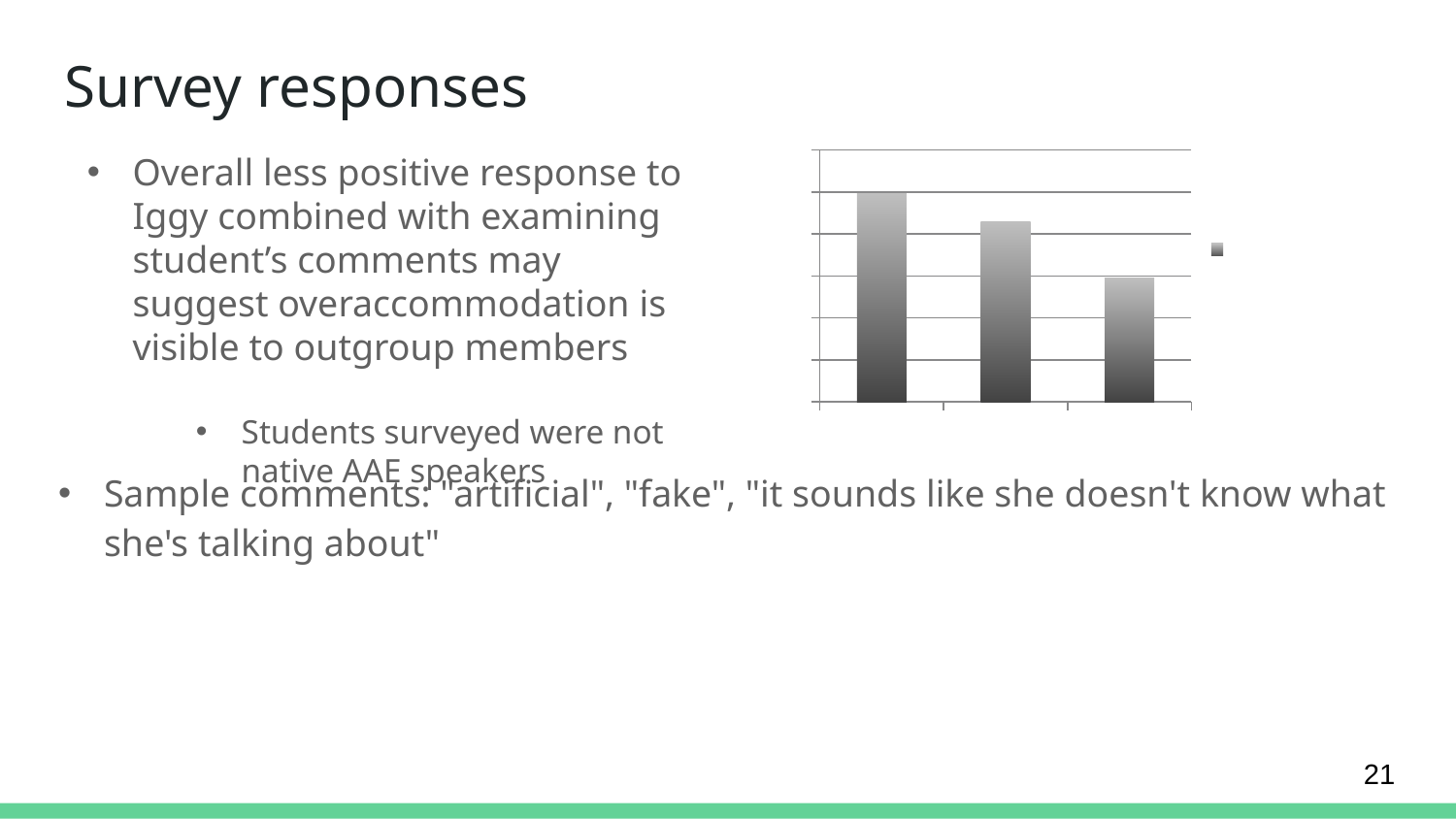
Do the bar values rise or fall from left to right across the chart? fall Which bar is the shortest in the chart: the left, middle, or right one? right How many series does the chart's legend list? 1 Is the left bar taller or shorter than the middle bar? taller Which bar is the tallest in the chart: the left, middle, or right one? left What kind of chart is shown on the slide? bar chart Are the bars in the chart vertical or horizontal? vertical How many bars are plotted in the chart? 3 Does the chart display a title above the plot area? No Is the middle bar taller or shorter than the right bar? taller